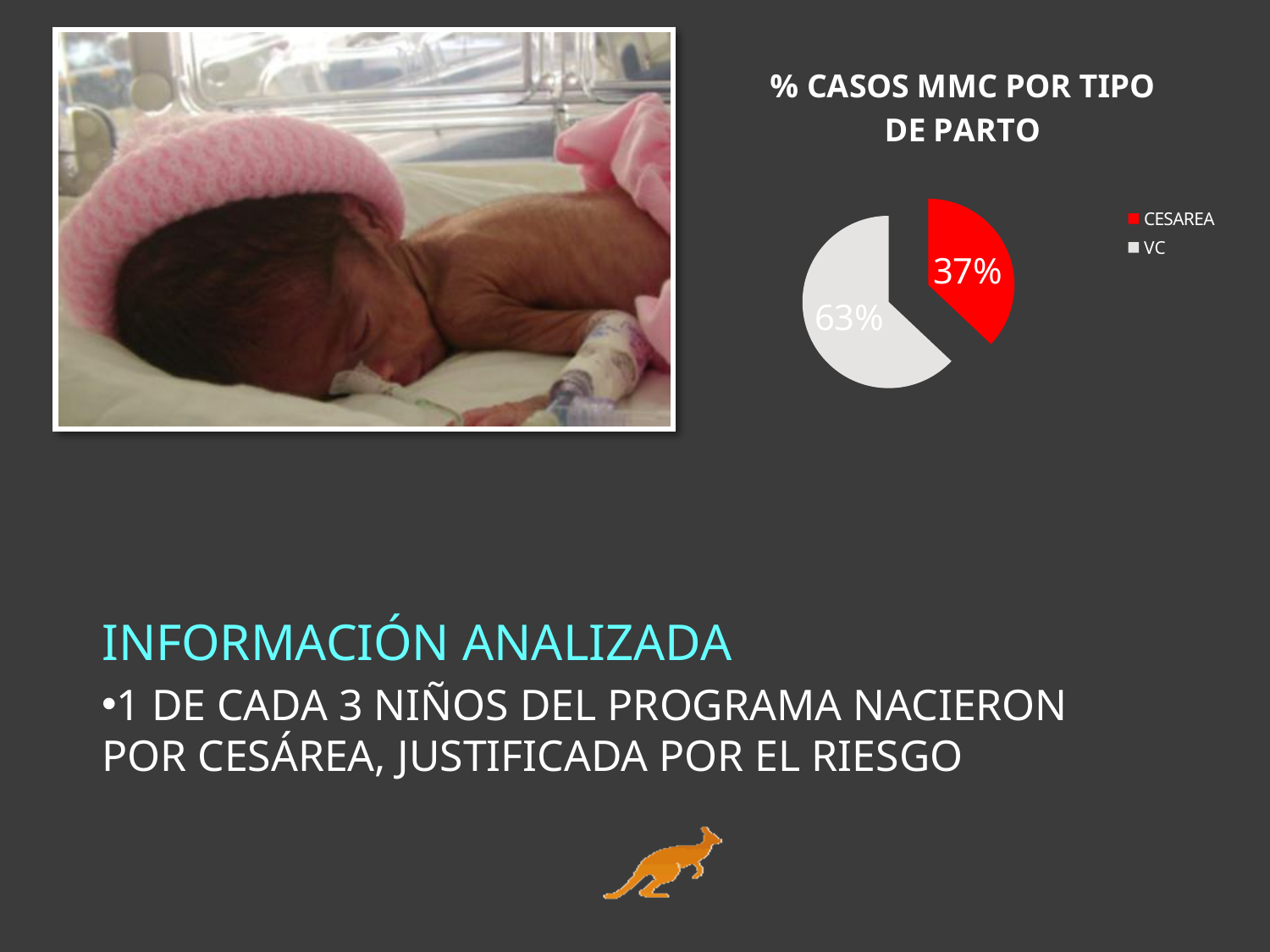
What is the title of the chart? % CASOS MMC POR TIPO DE PARTO Which is larger, the CESAREA slice or the VC slice? VC What percentage of cases does the CESAREA slice represent? 37% What kind of chart is shown on the slide? pie chart What percentage of cases does the VC slice represent? 63% What colour is the CESAREA slice in the pie chart? red How many slices does the pie chart have? 2 Is the share for CESAREA greater or less than 50%? less How many entries does the legend list? 2 What is the difference in percentage points between the VC and CESAREA slices? 26 Which category has the largest share of the pie? VC Which category has the smallest share of the pie? CESAREA